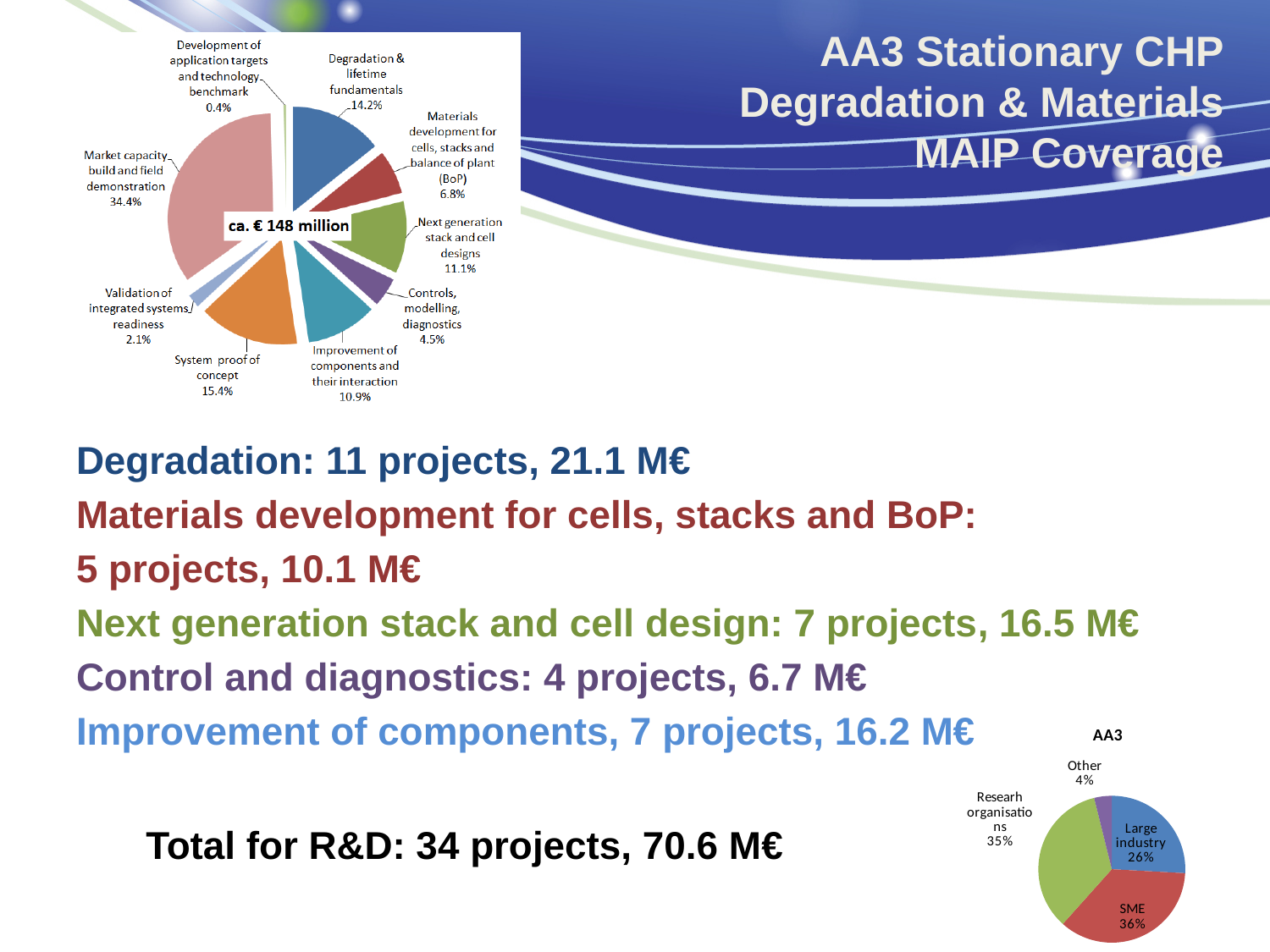
In the top-left pie chart, what share does Degradation & lifetime fundamentals have? 14.2% In the AA3 pie chart, what is the difference in share between Research organisations and Large industry? 9% In the AA3 pie chart, what share do SME have? 36% How many slices does the top-left pie chart have? 9 What total amount is shown in the centre of the top-left pie chart? ca. € 148 million In the top-left pie chart, what share does Market capacity build and field demonstration have? 34.4% In the AA3 pie chart, which category has the smallest share? Other In the top-left pie chart, which category has the largest share? Market capacity build and field demonstration In the top-left pie chart, which has the larger share: Improvement of components and their interaction or Controls, modelling, diagnostics? Improvement of components and their interaction In the top-left pie chart, which category has the smallest share? Development of application targets and technology benchmark What type of chart is the AA3 chart in the bottom-right corner? Pie chart In the top-left pie chart, what is the difference in share between System proof of concept and Next generation stack and cell designs? 4.3%